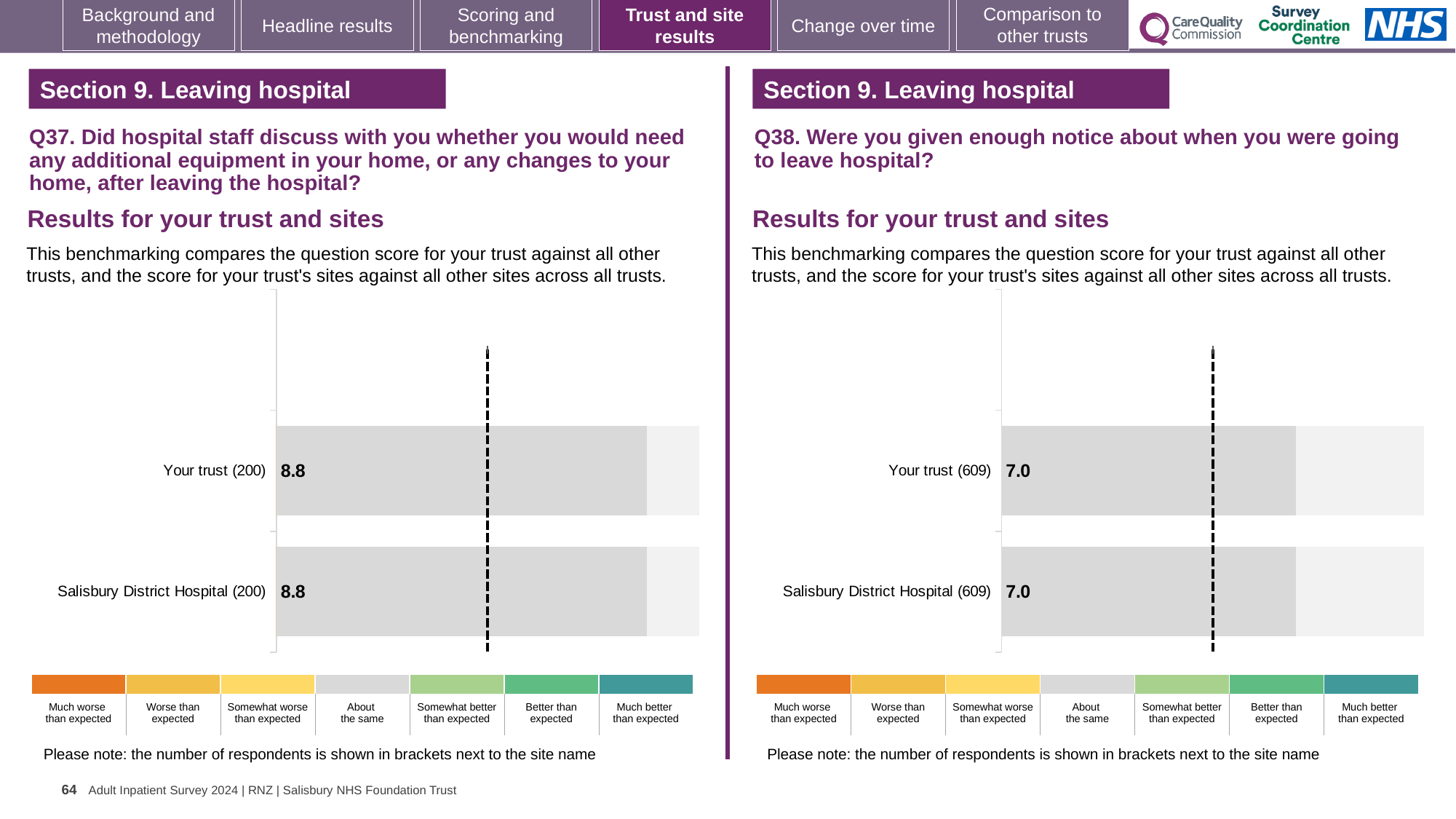
How many bars are plotted in the Q38 chart on the right? 2 What kind of chart is used for the Q38 results on the right? Bar chart In the Q37 chart on the left, what is the difference between the score for Your trust and the score for Salisbury District Hospital? 0.0 In the Q38 chart on the right, how many respondents are shown in brackets next to Salisbury District Hospital? 609 Is the score for Your trust in the Q37 chart on the left greater or less than the score for Your trust in the Q38 chart on the right? greater In the Q38 chart on the right, what is the difference between the score for Your trust and the score for Salisbury District Hospital? 0.0 In the Q38 chart on the right, what is the score for Salisbury District Hospital? 7.0 In the Q37 chart on the left, what is the score for Your trust? 8.8 In the Q37 chart on the left, how many respondents are shown in brackets next to Your trust? 200 How many bars are plotted in the Q37 chart on the left? 2 In the Q37 chart on the left, what is the score for Salisbury District Hospital? 8.8 In the Q38 chart on the right, what is the score for Your trust? 7.0